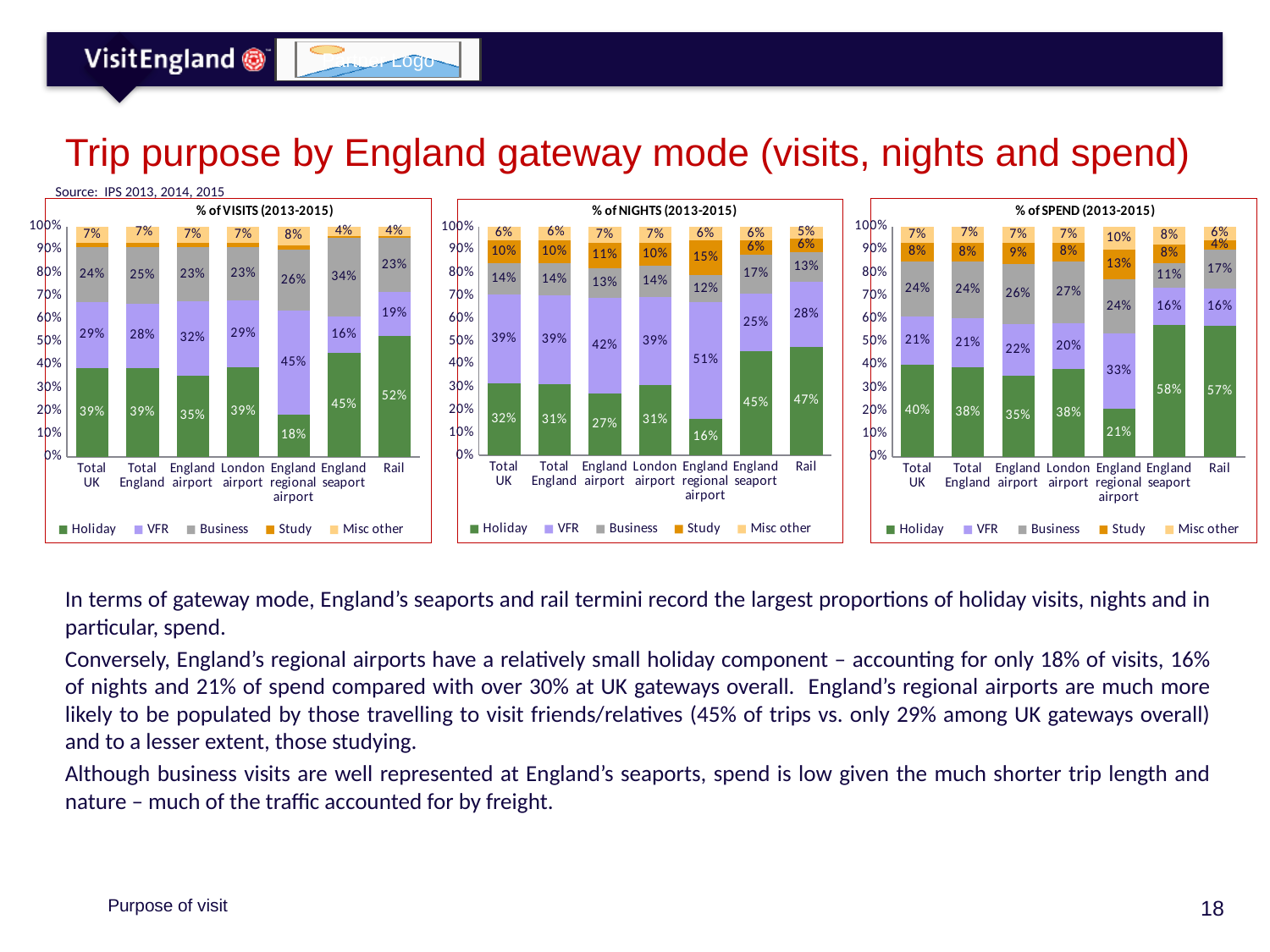
In the '% of SPEND (2013-2015)' chart, what is the difference between the Holiday share for England seaport and for England regional airport? 37% In the '% of VISITS (2013-2015)' chart, which gateway has the highest Holiday share? Rail In the '% of VISITS (2013-2015)' chart, what is the Business share for England seaport? 34% In the '% of VISITS (2013-2015)' chart, what is the VFR share for England regional airport? 45% In the '% of NIGHTS (2013-2015)' chart, what is the VFR share for England regional airport? 51% In the '% of SPEND (2013-2015)' chart, is the Holiday share for Total UK larger or the Holiday share for Total England? Total UK In the '% of VISITS (2013-2015)' chart, what is the Holiday share for England regional airport? 18% In the '% of NIGHTS (2013-2015)' chart, which gateway has the lowest Holiday share? England regional airport In the '% of NIGHTS (2013-2015)' chart, what is the Holiday share for Rail? 47% In the '% of SPEND (2013-2015)' chart, what is the Holiday share for England seaport? 58% How many gateway categories are shown on the x axis of the '% of NIGHTS (2013-2015)' chart? 7 How many series does the legend of the '% of SPEND (2013-2015)' chart list? 5